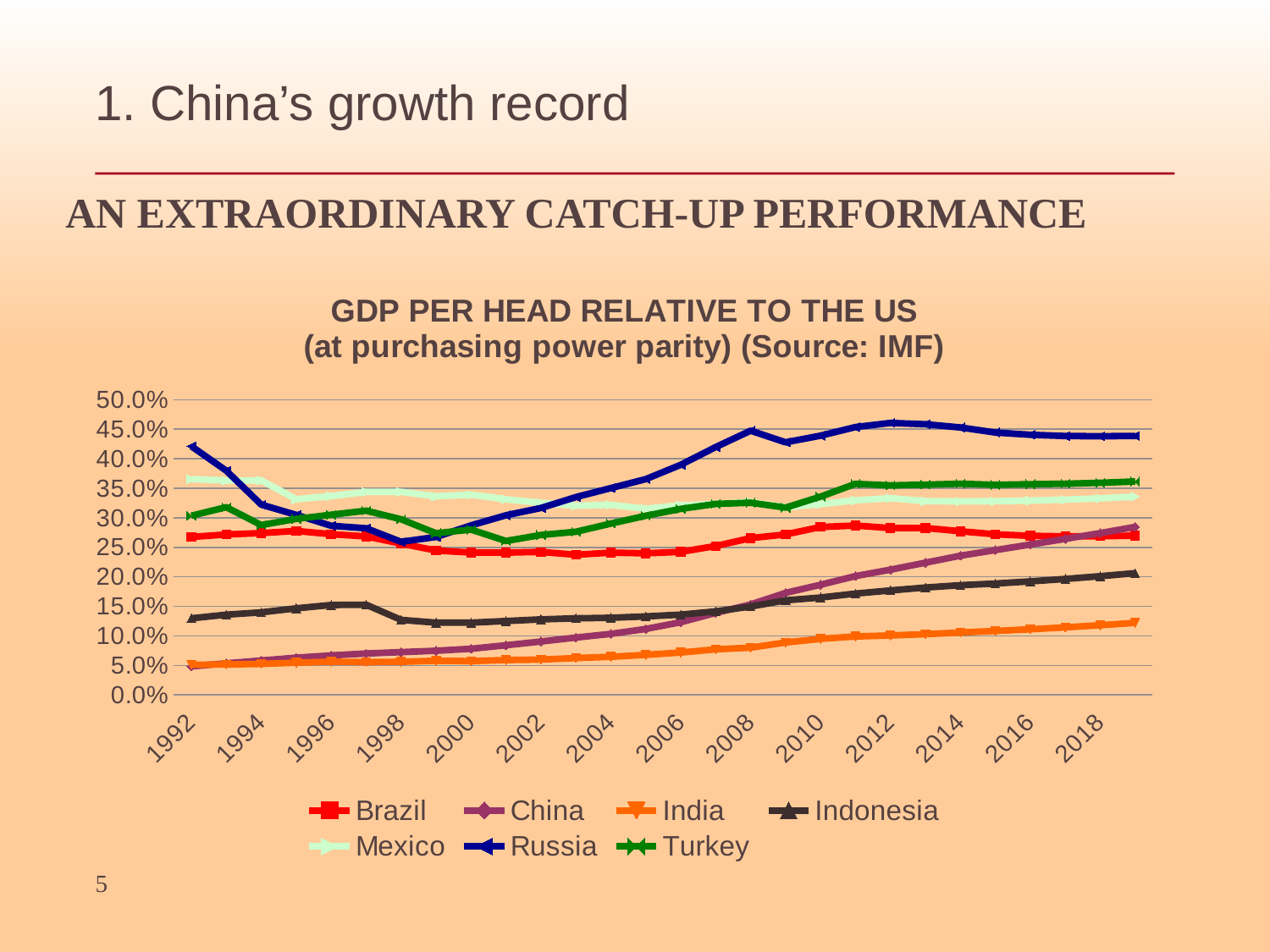
Is the value for China in 2019 greater or less than 25.0%? greater Is the value for Russia in 1992 greater or less than 40.0%? greater Does China's line rise or fall from 1992 to 2019? rise Which country has the highest GDP per head relative to the US in 2019? Russia In 2019, which is larger: the value for China or the value for Indonesia? China Which country has the highest value in 1992? Russia Which country has the lowest GDP per head relative to the US in 2019? India How many series does the legend list? 7 In 2019, which is larger: the value for Russia or the value for Mexico? Russia What is the title of the chart? GDP PER HEAD RELATIVE TO THE US (at purchasing power parity) (Source: IMF) What kind of chart is shown on the slide? line chart Is the value for Indonesia in 1992 greater or less than 10.0%? greater